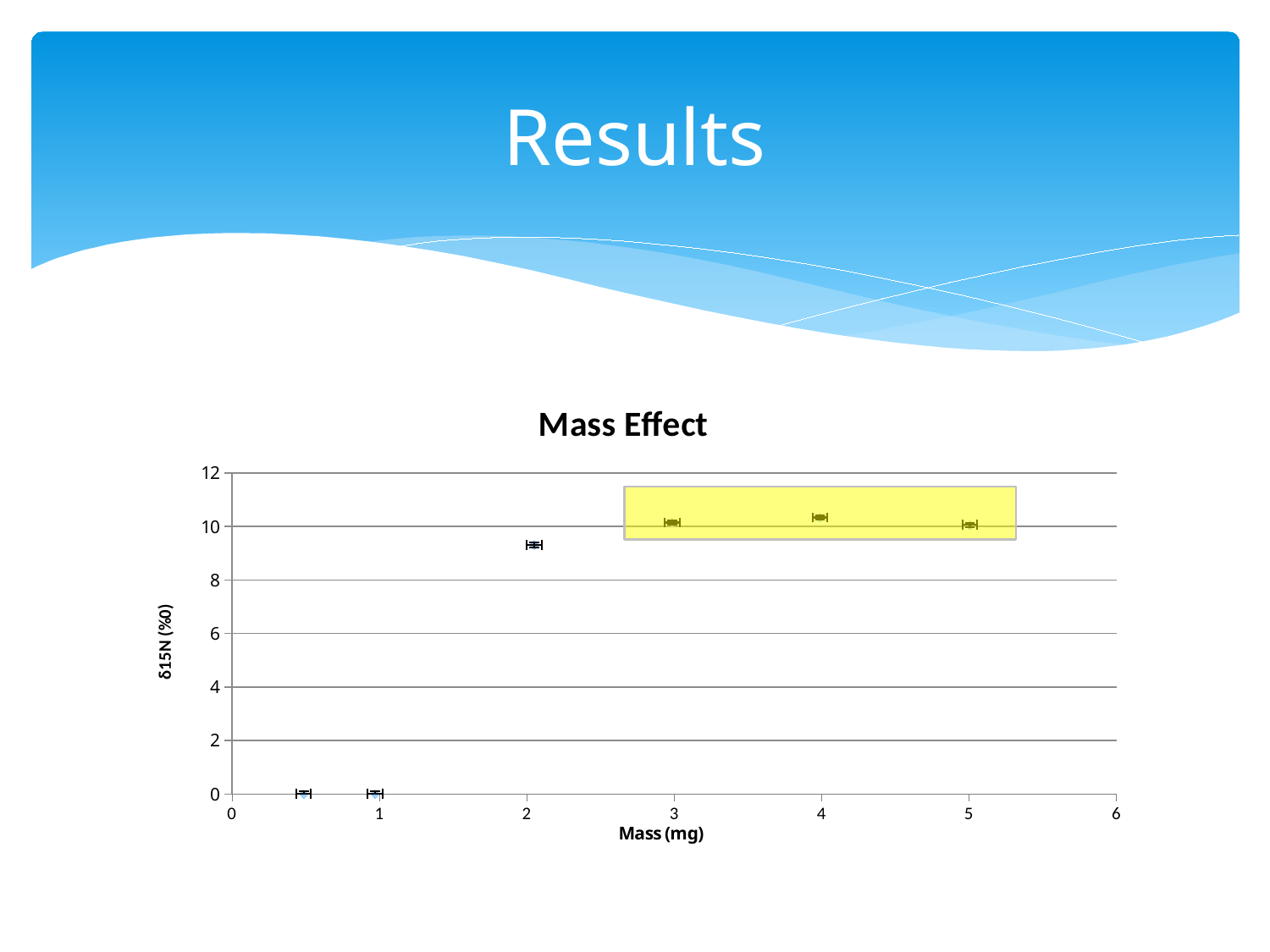
Which has the higher δ15N value: the point at 2 mg or the point at 3 mg? 3 mg Is the δ15N value at a mass of 2 mg greater or less than 10? less Do the δ15N values generally rise or fall as mass increases from 0 to 5 mg? rise How many data points are plotted in the chart? 6 Is the δ15N value at a mass of 4 mg greater or less than 10? greater What is the label of the x axis of the chart? Mass (mg) How many data points lie inside the yellow highlighted box? 3 Which has the higher δ15N value: the point at 1 mg or the point at 2 mg? 2 mg What kind of chart is shown on the slide? scatter chart Is the δ15N value at a mass of 2 mg greater or less than 8? greater What is the title of the chart? Mass Effect